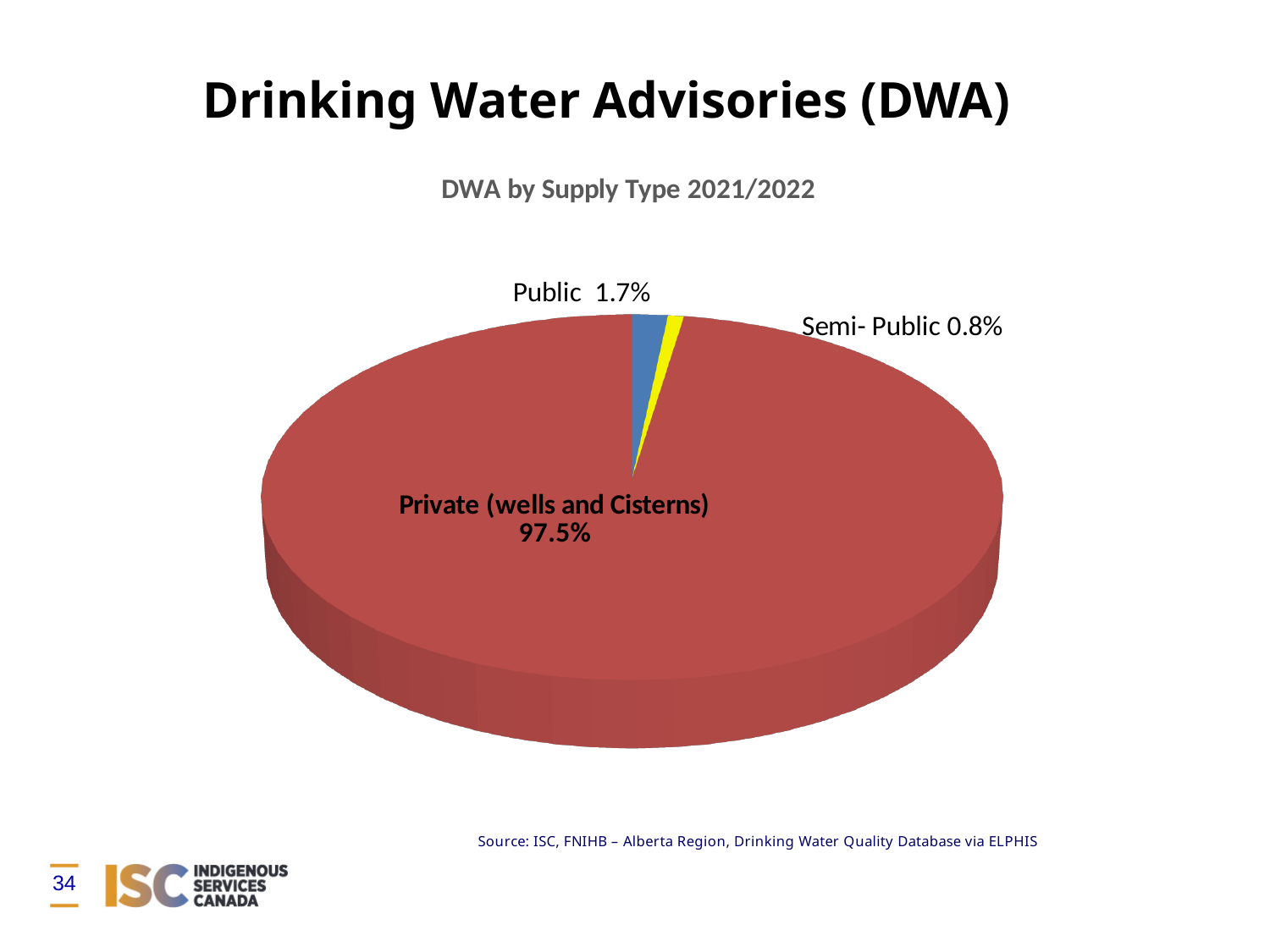
Which is larger, the Public share or the Semi-Public share? Public How many supply types are shown in the pie chart? 3 What is the difference in percentage points between the Public and Semi-Public shares? 0.9 What kind of chart is shown on the slide? Pie chart What is the difference in percentage points between the Private (wells and Cisterns) share and the Public share? 95.8 What colour is the slice for Private (wells and Cisterns)? Red Which supply type has the largest share of DWAs? Private (wells and Cisterns) What share of DWAs is attributed to Semi-Public supply? 0.8% What share of DWAs is attributed to Private (wells and Cisterns)? 97.5% What is the title of the chart? DWA by Supply Type 2021/2022 What share of DWAs is attributed to Public supply? 1.7% Which supply type has the smallest share of DWAs? Semi-Public